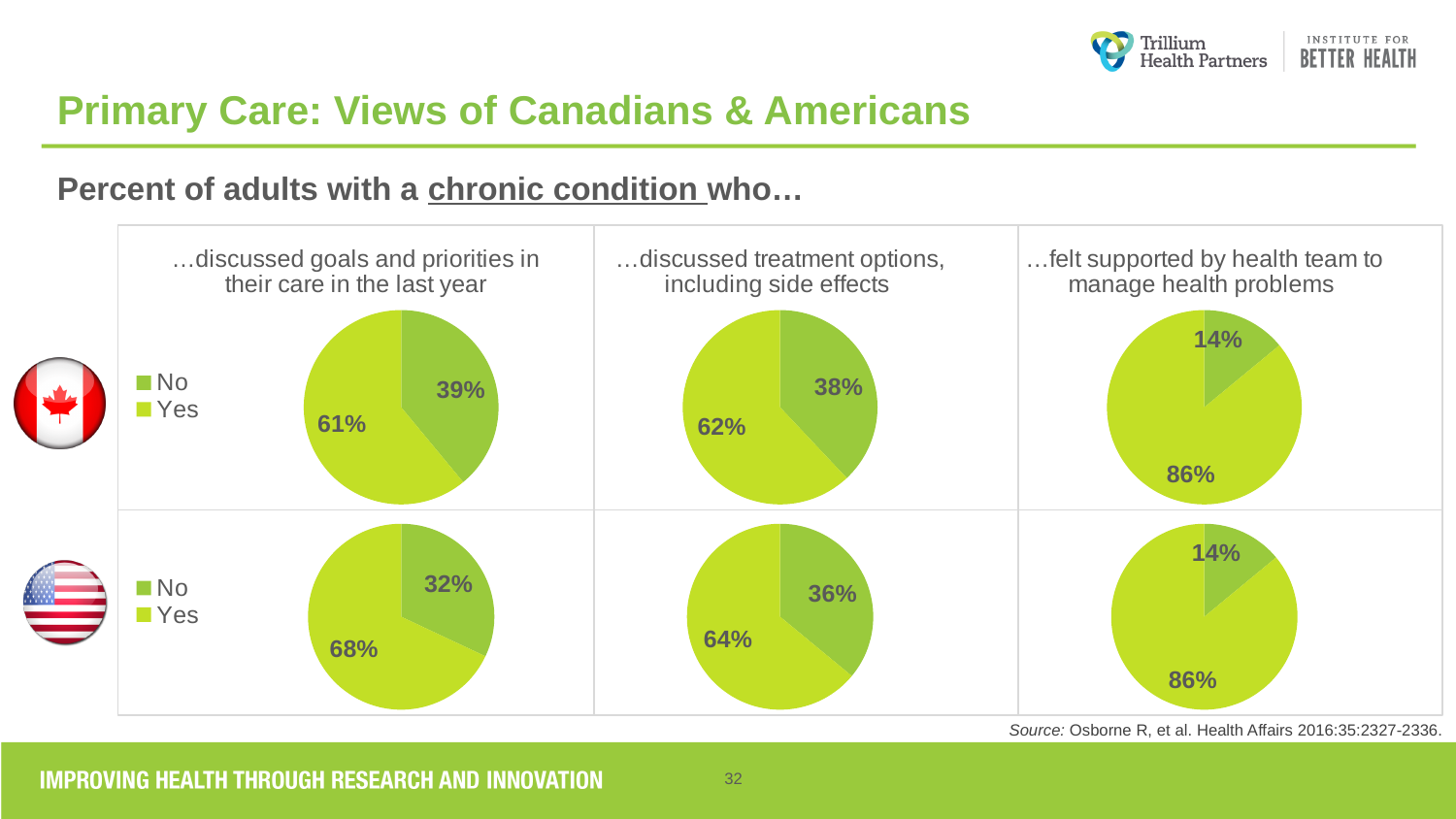
What type of chart is used to show the responses on this slide? Pie chart In the Canada pie chart for "discussed treatment options, including side effects", what percentage answered No? 38% In the "discussed treatment options, including side effects" charts, which country has the larger Yes share, Canada or the United States? United States How many pie charts are shown on the slide? 6 In the United States pie chart for "felt supported by health team to manage health problems", what percentage answered No? 14% In the Canada pie chart for "discussed goals and priorities in their care in the last year", what percentage answered Yes? 61% In the United States pie chart for "discussed goals and priorities in their care in the last year", what percentage answered No? 32% In the Canada pie chart for "felt supported by health team to manage health problems", what percentage answered Yes? 86% In the United States pie chart for "discussed treatment options, including side effects", what percentage answered Yes? 64% What is the difference between the Yes share for the United States and the Yes share for Canada in the "discussed goals and priorities in their care in the last year" charts? 7 percentage points How many series does the legend list for each row of charts? 2 In the Canada pie chart for "discussed goals and priorities in their care in the last year", which response is the largest slice? Yes